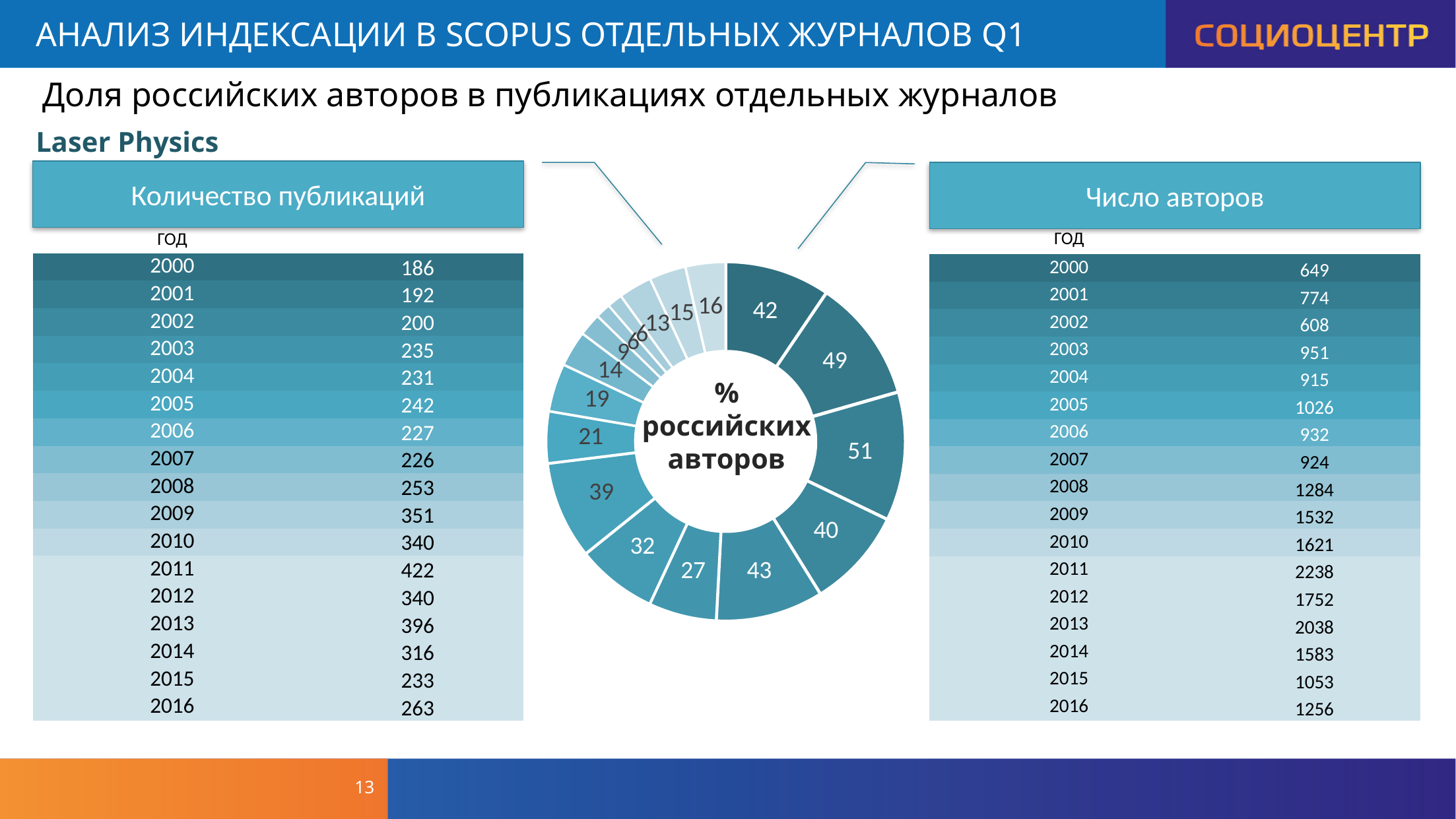
What value is labelled on the darkest slice at the top of the doughnut chart, starting at the 12 o'clock position? 42 What kind of chart is shown in the centre of the slide? doughnut chart What is the smallest value labelled on a slice of the doughnut chart? 6 How many slices does the doughnut chart have? 17 How many slices of the doughnut chart are labelled with a value greater than 40? 4 What is the largest value labelled on a slice of the doughnut chart? 51 Which is larger on the doughnut chart, the slice labelled 39 or the slice labelled 32? 39 What text is written in the centre of the doughnut chart? % российских авторов What value is labelled on the slice at the right-hand (3 o'clock) side of the doughnut chart? 51 What is the difference between the largest and the smallest slice values labelled on the doughnut chart? 45